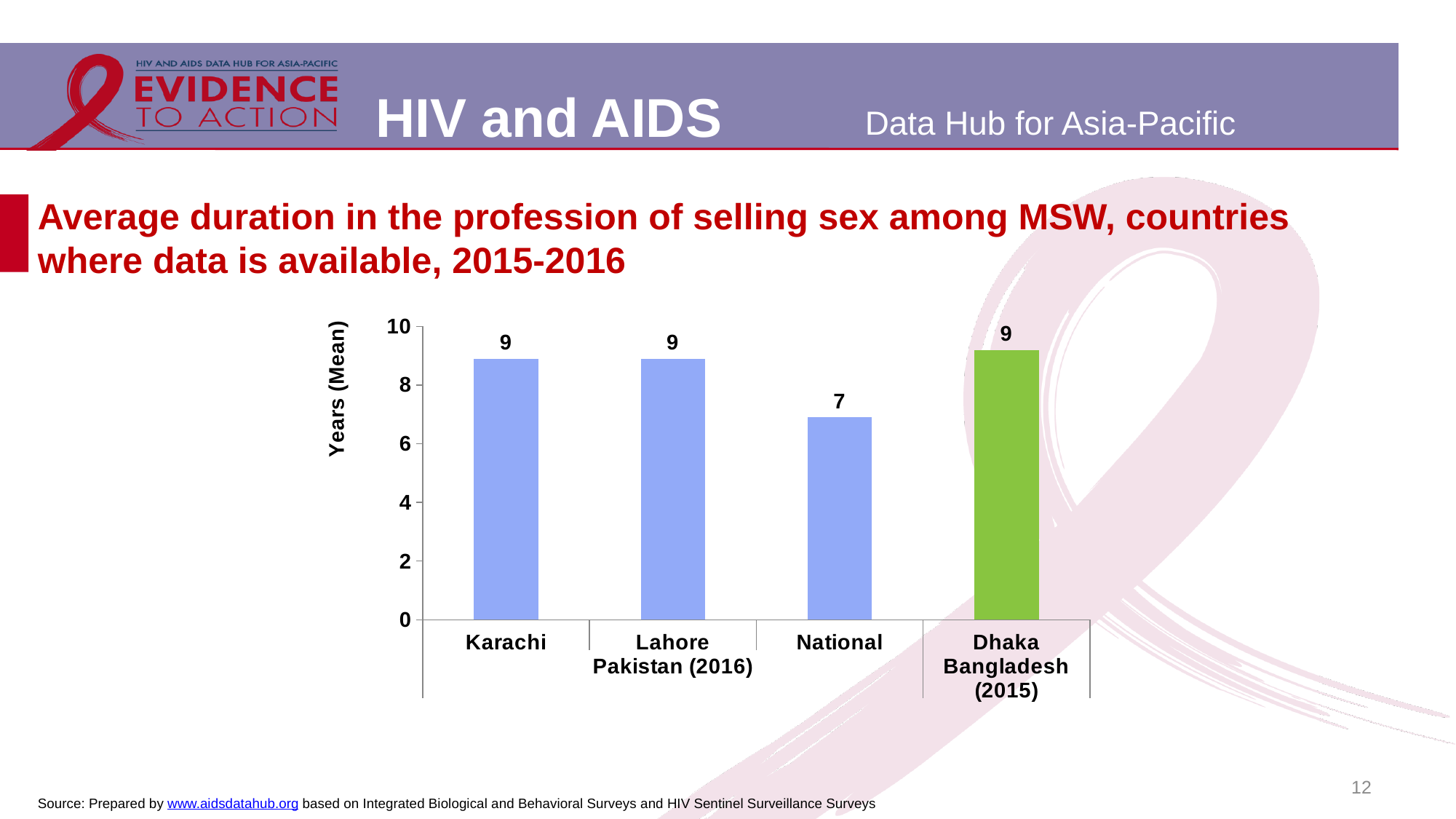
How many categories are shown on the x axis? 4 What is the average duration in years for Lahore? 9 Which is larger, the value for Lahore or the value for National? Lahore Is the value for National greater or less than 8? less What is the average duration in years for Dhaka, Bangladesh (2015)? 9 What is the average duration in years for National (Pakistan)? 7 What is the difference in years between Karachi and National? 2 What kind of chart is shown on the slide? bar chart What is the average duration in years for Karachi? 9 Which category has the lowest average duration? National Is the value for Dhaka greater or less than 8? greater What is the label of the y axis? Years (Mean)